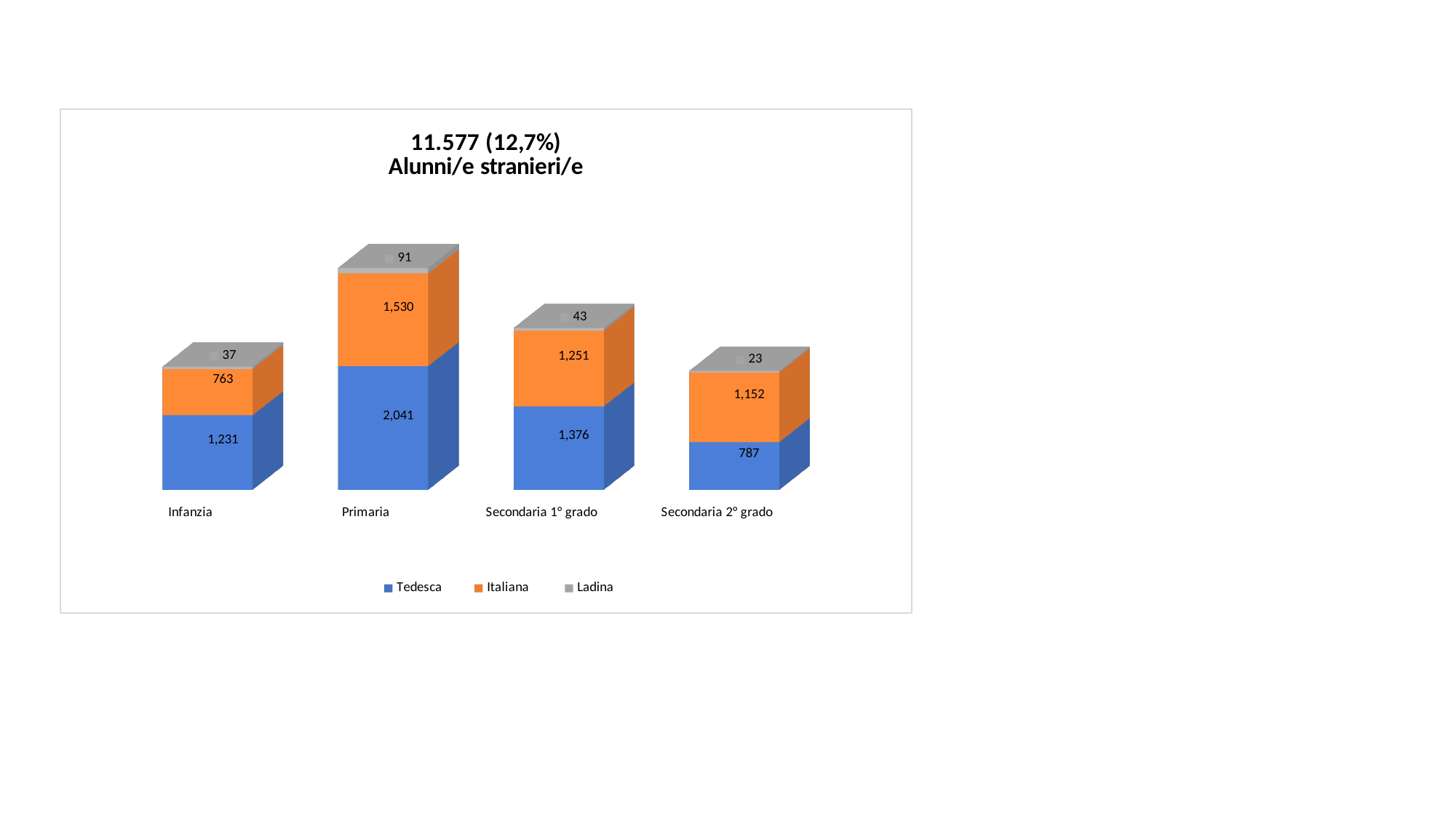
Which category has the lowest Ladina value? Secondaria 2° grado What is the Ladina value for Infanzia? 37 How many categories are shown on the x axis? 4 What is the Tedesca value for Primaria? 2,041 Which is larger for Secondaria 2° grado, the Tedesca value or the Italiana value? Italiana What is the Italiana value for Secondaria 2° grado? 1,152 How many series does the legend list? 3 What is the total of the stacked bar for Secondaria 1° grado? 2,670 What kind of chart is shown? Stacked bar chart What is the title of the chart? 11.577 (12,7%) Alunni/e stranieri/e What is the difference between the Italiana values for Primaria and Infanzia? 767 Which category has the highest Tedesca value? Primaria